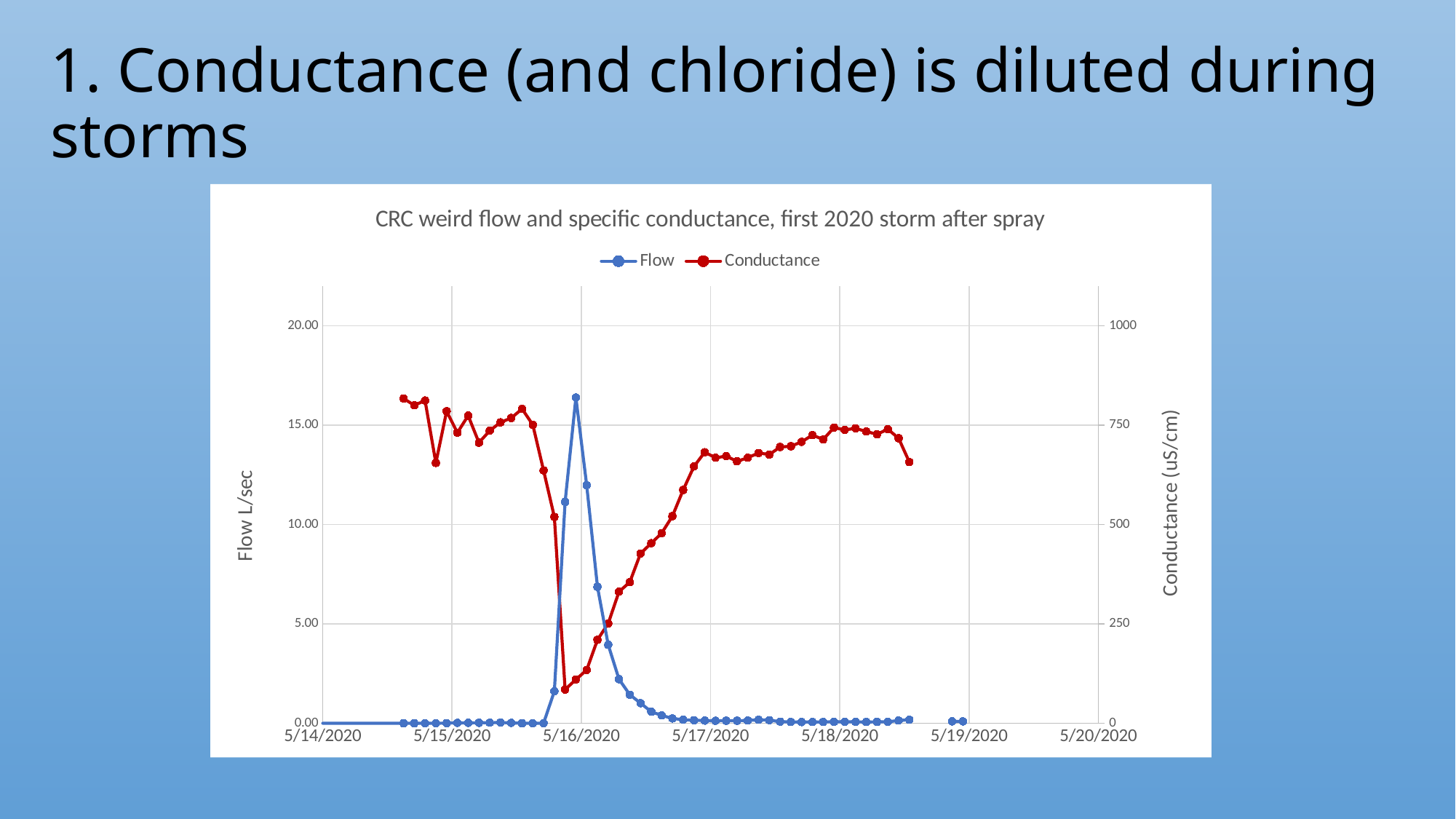
What is the title of the chart? CRC weird flow and specific conductance, first 2020 storm after spray Is the peak value of the Flow series greater or less than 15.00? greater Is the first Conductance value (around 5/14/2020) greater or less than 750? greater Does the Conductance series rise or fall between 5/16/2020 and 5/17/2020? rise Is the lowest value of the Conductance series greater or less than 250? less How many series does the legend list? 2 Around which date does the Flow series reach its highest value? 5/16/2020 What kind of chart is shown on the slide? line chart Does the Flow series rise or fall between 5/16/2020 and 5/17/2020? fall Which series is plotted in red? Conductance